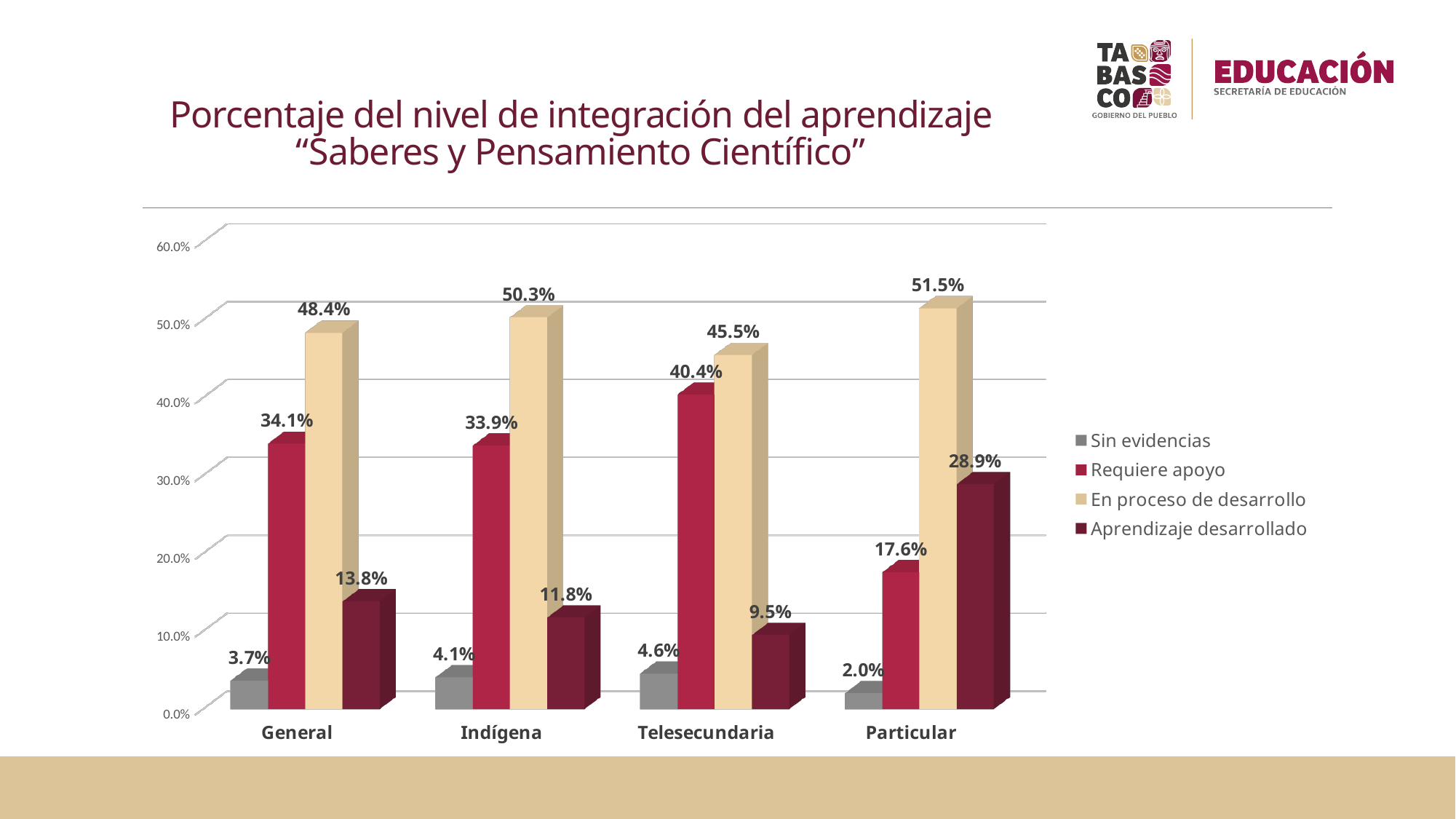
What is the value for "En proceso de desarrollo" in the Particular category? 51.5% Is the value for "Requiere apoyo" in Telesecundaria greater or less than 40.0%? greater What is the value for "Requiere apoyo" in the Telesecundaria category? 40.4% Which category has the lowest value for "Sin evidencias"? Particular How many series does the legend list? 4 What is the value for "Sin evidencias" in the Indígena category? 4.1% What kind of chart is shown on the slide? Bar chart Which legend entry is shown in grey? Sin evidencias How many categories are shown on the x axis? 4 Which is larger: "Requiere apoyo" for General or "Requiere apoyo" for Indígena? General What is the difference between the "En proceso de desarrollo" values for Particular and General? 3.1% Which category has the highest value for "Aprendizaje desarrollado"? Particular